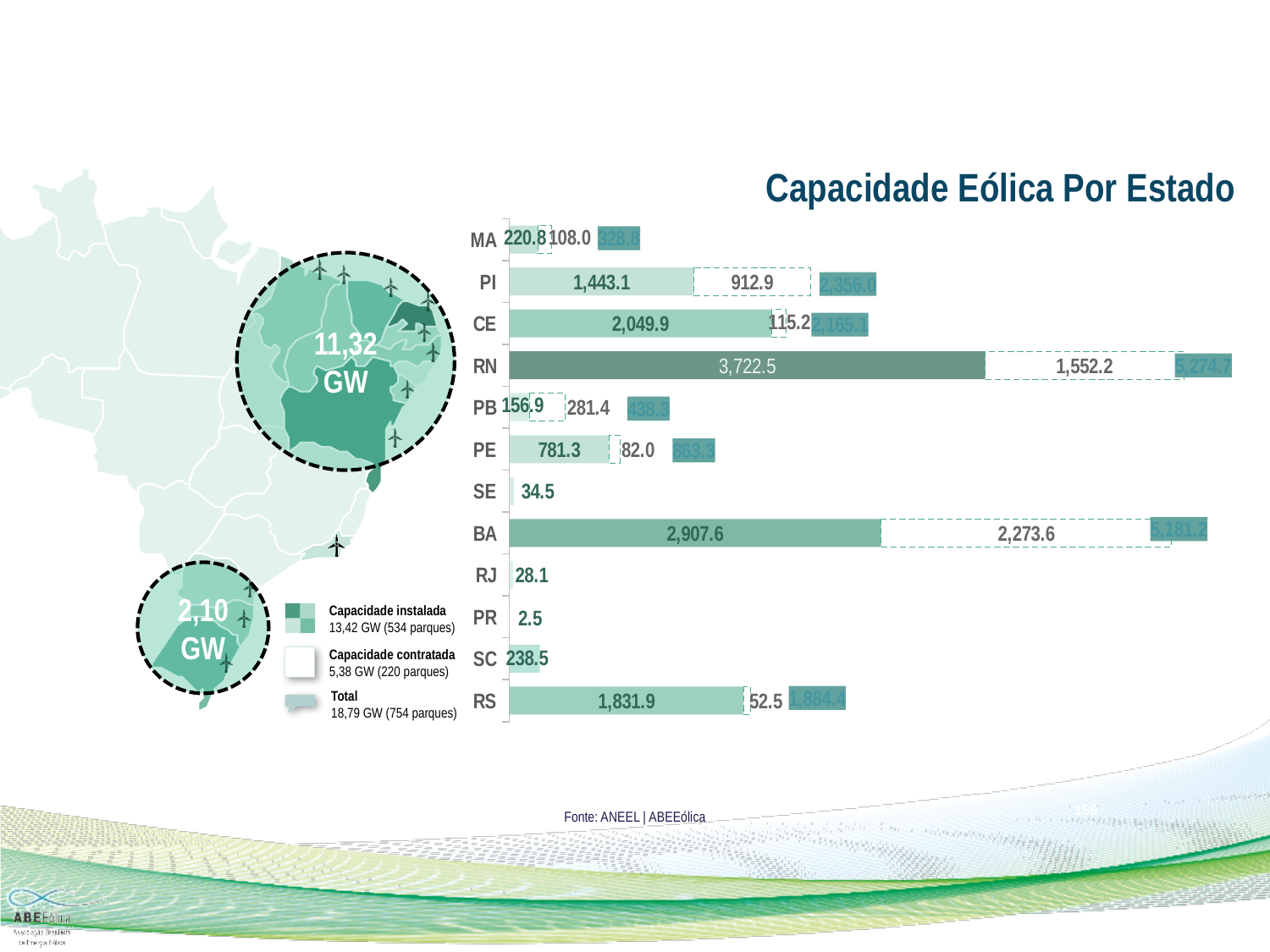
What is the contracted capacity (Capacidade contratada) value for BA? 2,273.6 How many entries does the legend list? 3 What kind of chart is shown on the slide? bar chart Which state has the larger contracted capacity (Capacidade contratada), PI or CE? PI What is the title of the chart? Capacidade Eólica Por Estado What is the difference between the installed capacity of RN and the installed capacity of BA? 814.9 Which state has the lowest installed capacity (Capacidade instalada)? PR Which state has the highest installed capacity (Capacidade instalada)? RN How many states are shown in the chart? 12 What is the contracted capacity (Capacidade contratada) value for PB? 281.4 What is the installed capacity (Capacidade instalada) value for RN? 3,722.5 What is the total of the stacked bar for RS (installed plus contracted)? 1,884.4